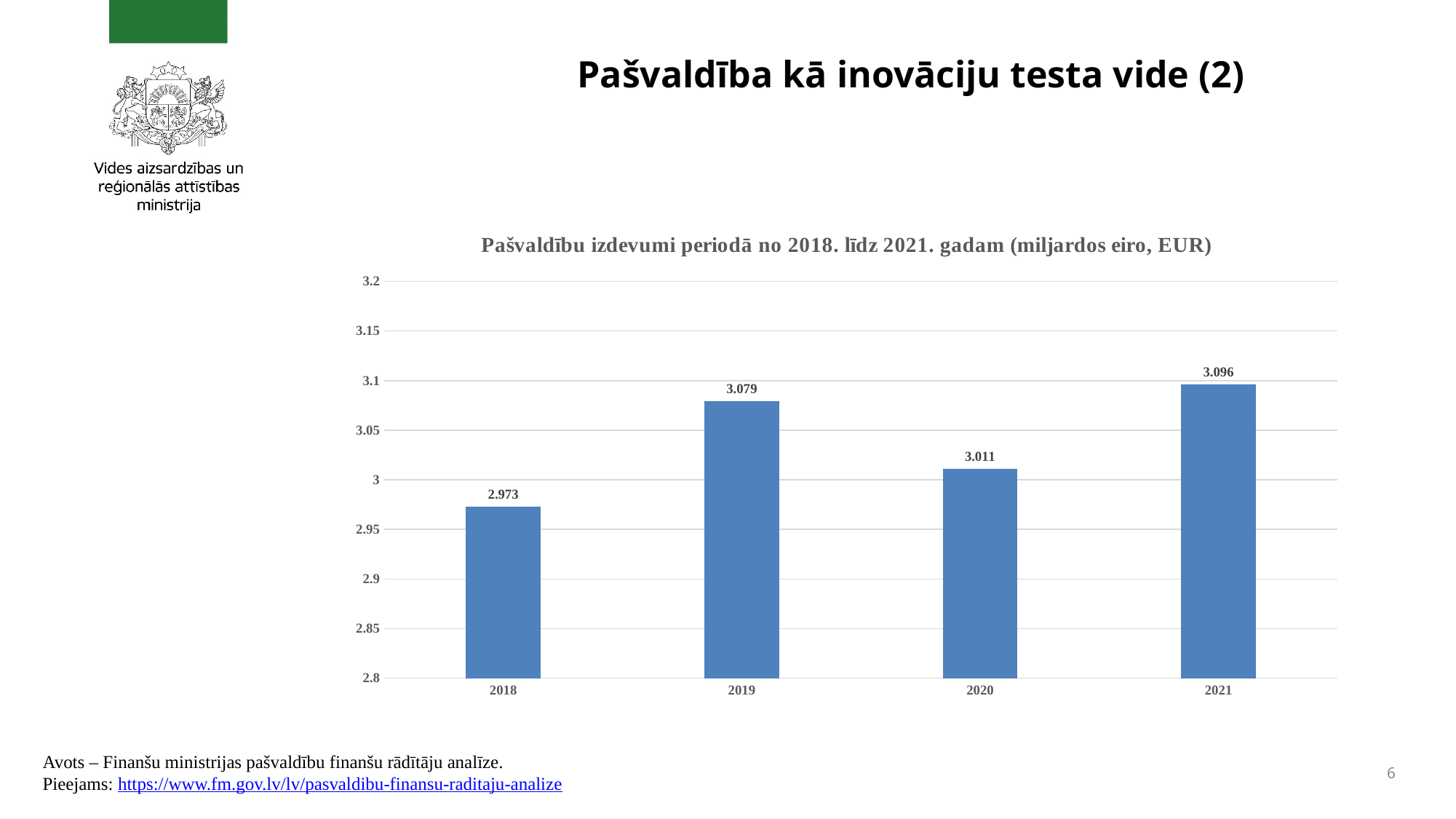
What is the value for 2019? 3.079 What is the value for 2021? 3.096 What kind of chart is shown on the slide? bar chart What is the difference between the values for 2021 and 2018? 0.123 Is the value for 2018 greater or less than 3? less How many years are shown on the x axis? 4 Which year has the highest value? 2021 What is the title of the chart? Pašvaldību izdevumi periodā no 2018. līdz 2021. gadam (miljardos eiro, EUR) Which is larger, the value for 2019 or the value for 2020? 2019 What is the value for 2018? 2.973 What is the value for 2020? 3.011 Which year has the lowest value? 2018